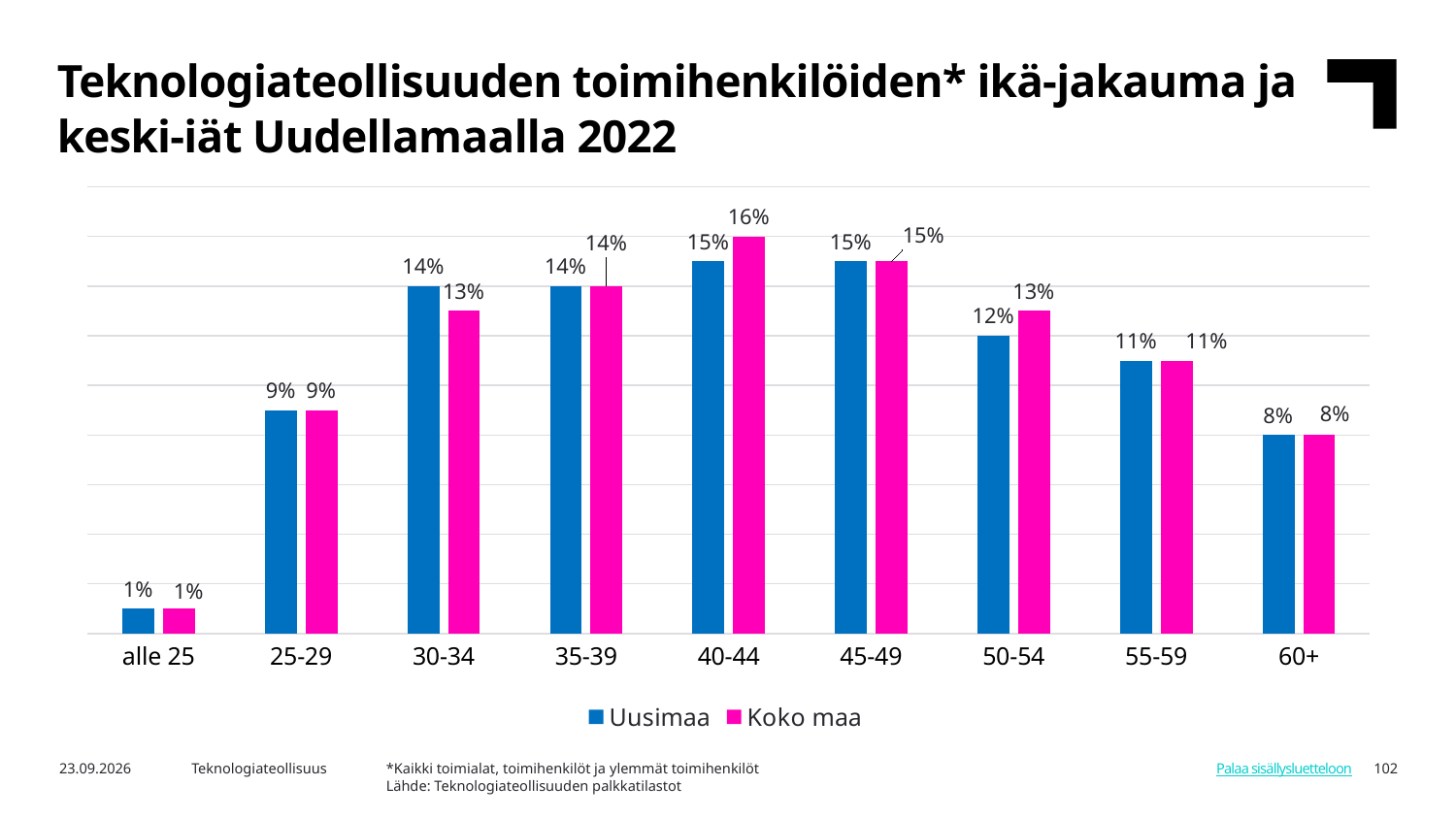
What is the Koko maa value for the 60+ age group? 8% How many series does the legend list? 2 How many age groups are shown on the x axis? 9 What is the Uusimaa value for the 30-34 age group? 14% What is the Koko maa value for the 40-44 age group? 16% What is the difference between the Koko maa and Uusimaa values for the 50-54 age group? 1% For the 30-34 age group, which series has the larger value, Uusimaa or Koko maa? Uusimaa Which age group has the lowest Uusimaa value? alle 25 Which series is shown in pink? Koko maa What is the Uusimaa value for the 50-54 age group? 12% Which age group has the highest Koko maa value? 40-44 What kind of chart is shown on the slide? Bar chart